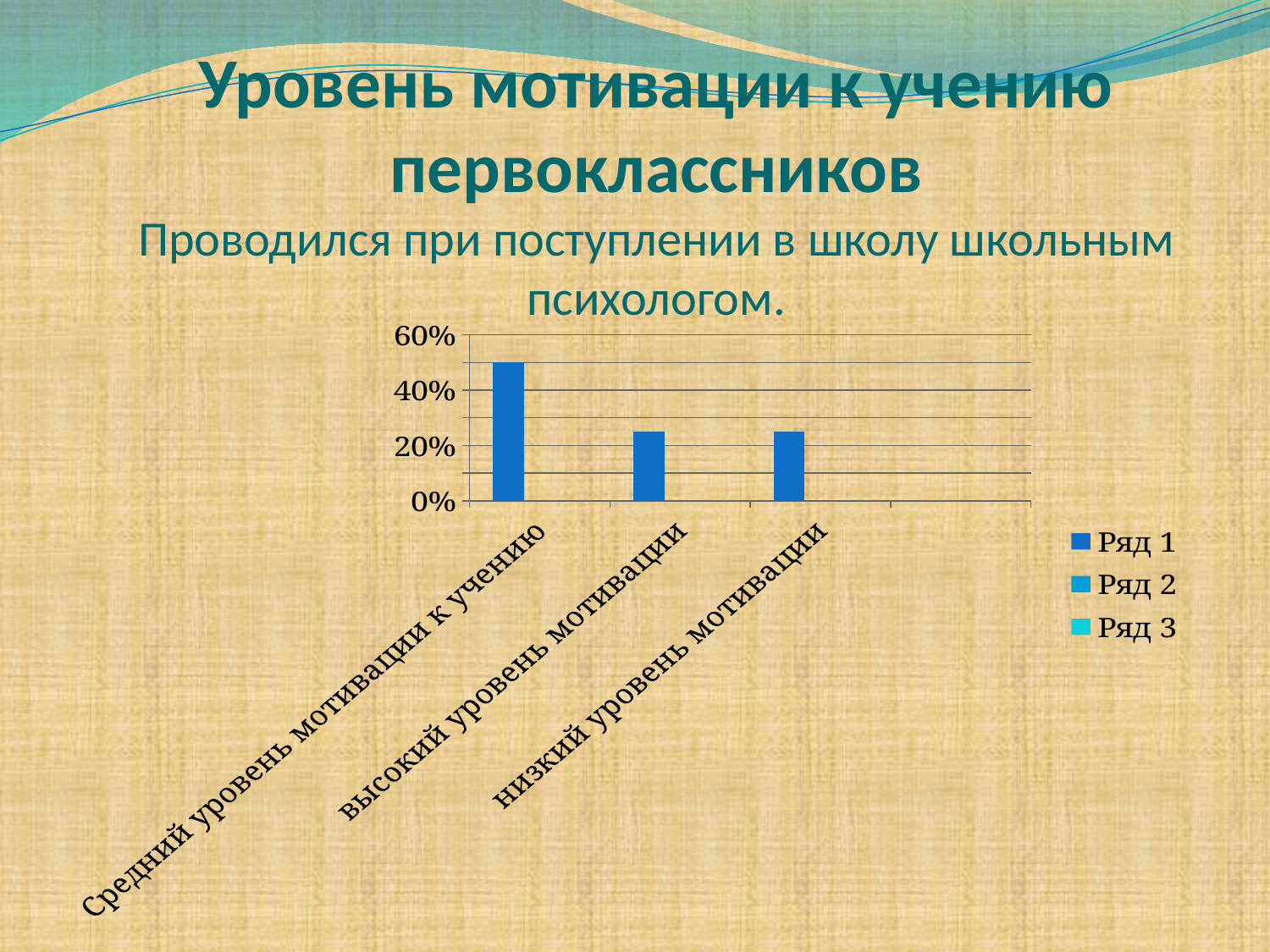
Is the value for "Средний уровень мотивации к учению" greater or less than 60%? less Which is larger: the value for "Средний уровень мотивации к учению" or the value for "высокий уровень мотивации"? Средний уровень мотивации к учению How many series does the chart's legend list? 3 Which category has the highest value in the chart? Средний уровень мотивации к учению How many categories are shown on the x axis of the chart? 3 What is the name of the first series listed in the chart's legend? Ряд 1 Is the value for "высокий уровень мотивации" greater or less than 20%? greater Is the value for "низкий уровень мотивации" greater or less than 40%? less What kind of chart is shown on the slide? bar chart What is the highest value shown on the chart's vertical axis? 60%